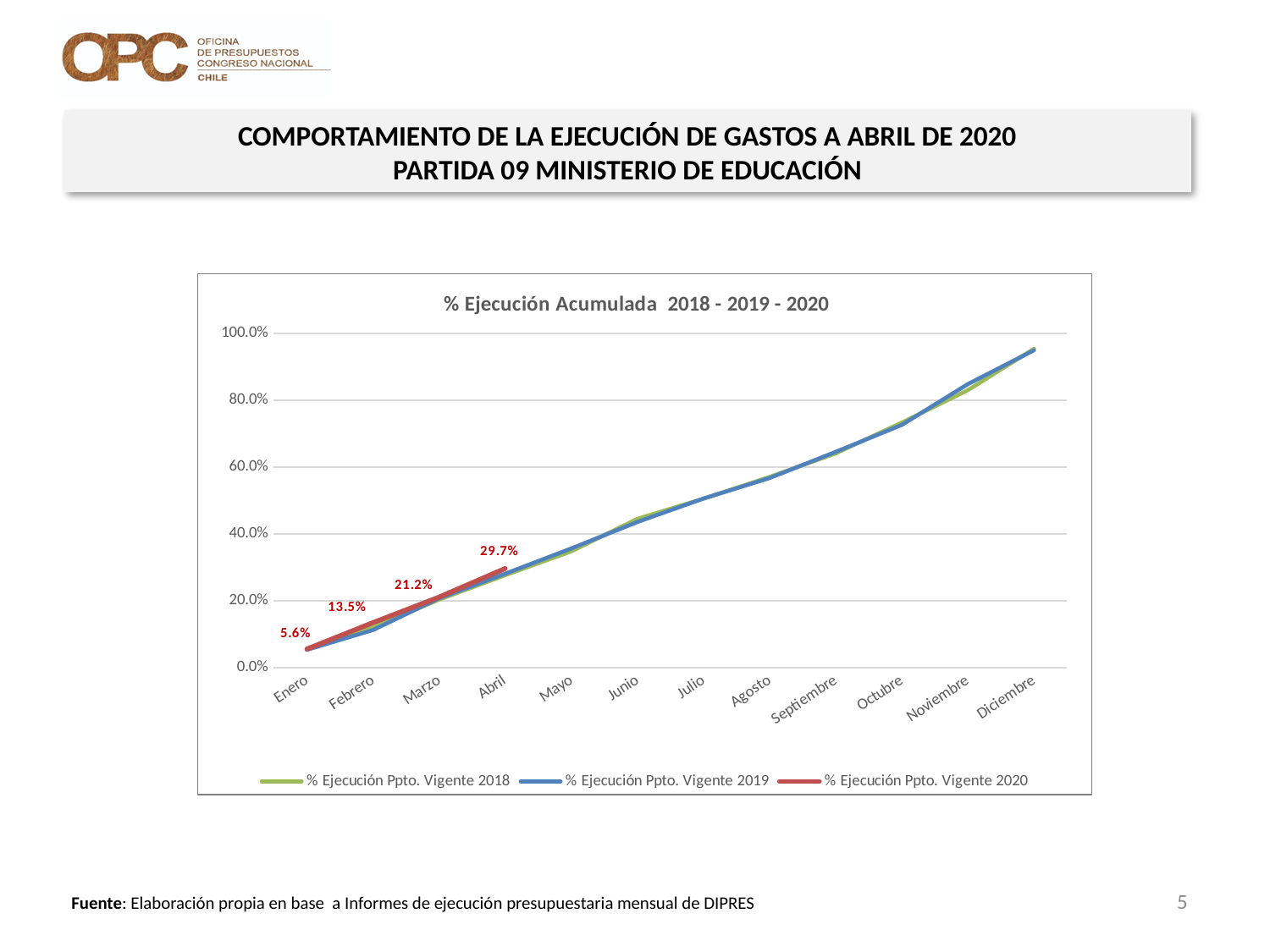
What is the value for % Ejecución Ppto. Vigente 2020 in Enero? 5.6% What is the title of the chart? % Ejecución Acumulada 2018 - 2019 - 2020 What is the difference between the 2020 values for Abril and Enero? 24.1% Is the value for % Ejecución Ppto. Vigente 2019 in Diciembre greater or less than 80.0%? greater What is the value for % Ejecución Ppto. Vigente 2020 in Febrero? 13.5% Do the values for the 2019 series rise or fall from Enero to Diciembre? rise Which month has the highest value for the 2020 series? Abril What is the value for % Ejecución Ppto. Vigente 2020 in Abril? 29.7% What type of chart is shown on the slide? line chart How many months are shown on the x axis? 12 How many series does the legend list? 3 What is the value for % Ejecución Ppto. Vigente 2020 in Marzo? 21.2%